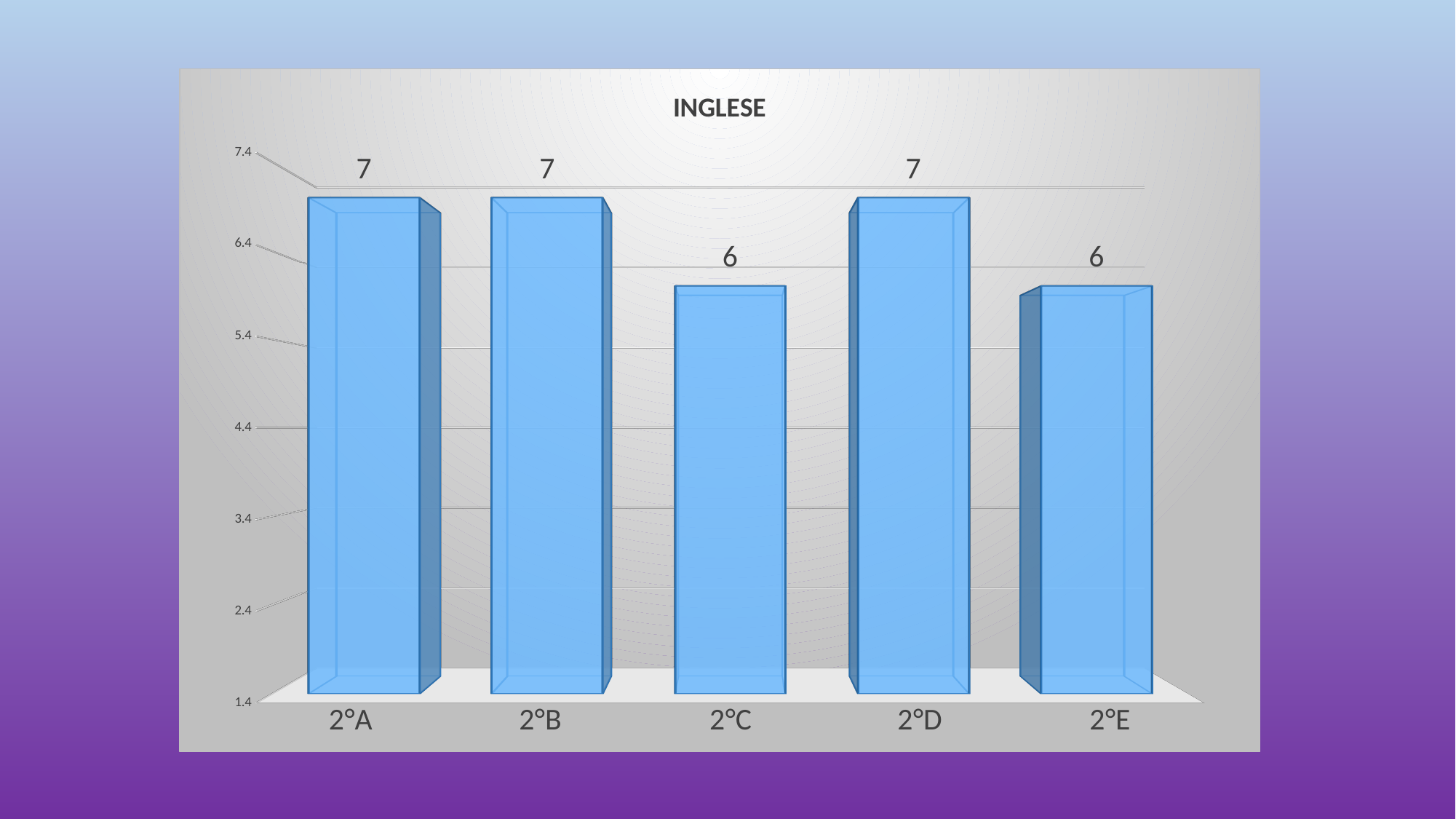
What is the value for 2°C? 6 What is the value for 2°E? 6 Is the value for 2°E greater or less than 5.4? greater What kind of chart is shown on the slide? Bar chart Which category has the lowest value, 2°B or 2°C? 2°C What is the difference between the values for 2°A and 2°C? 1 What is the title of the chart? INGLESE What is the value for 2°D? 7 What is the value for 2°A? 7 Is the value for 2°D larger than the value for 2°E? Yes How many categories have a value of 7? 3 How many categories are shown on the x axis? 5